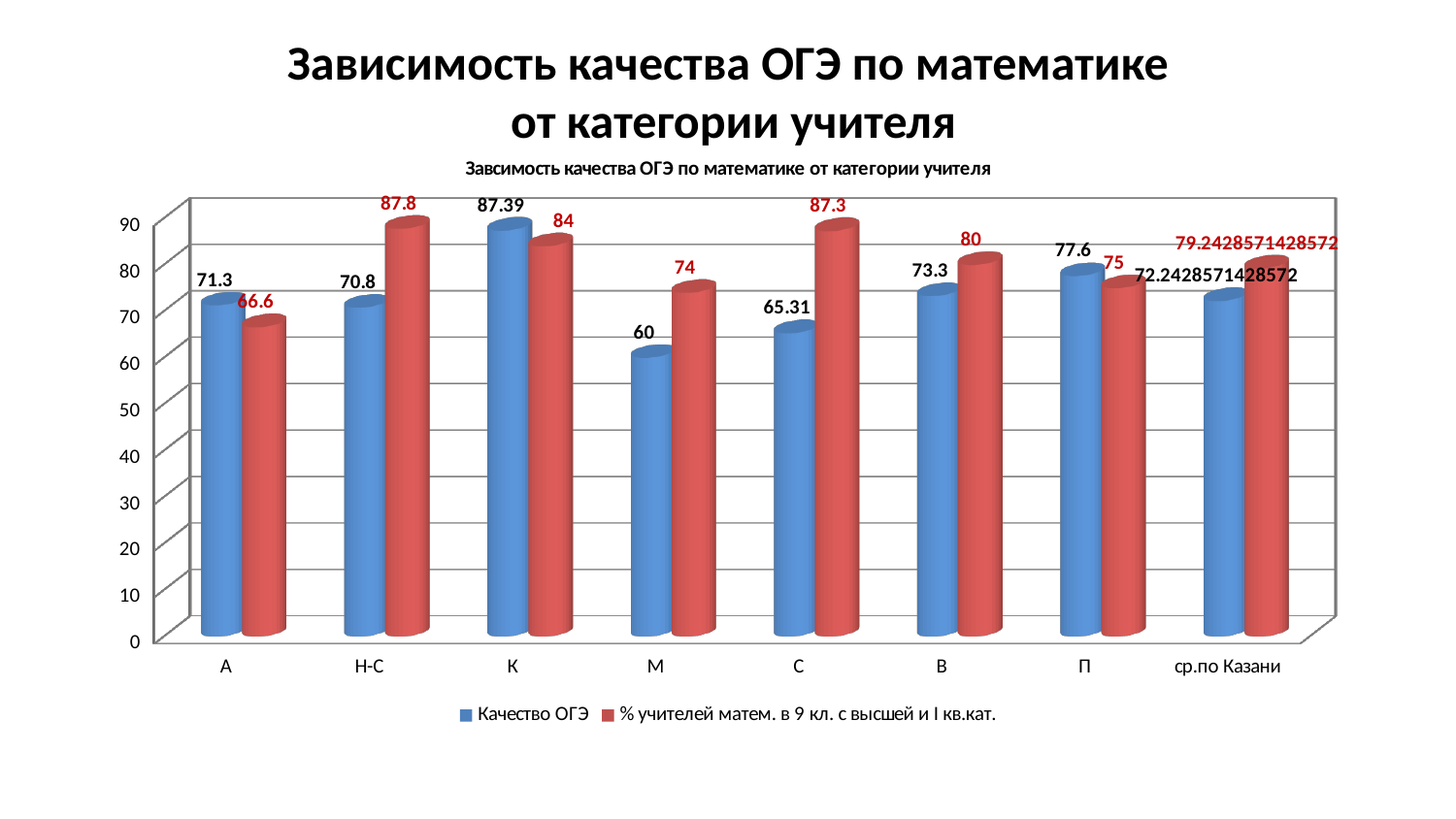
For category С, which is larger: Качество ОГЭ or % учителей матем. в 9 кл. с высшей и I кв.кат.? % учителей матем. в 9 кл. с высшей и I кв.кат. What kind of chart is shown on the slide? Bar chart What is the value of % учителей матем. в 9 кл. с высшей и I кв.кат. for category Н-С? 87.8 What is the difference between the % учителей матем. в 9 кл. с высшей и I кв.кат. value and the Качество ОГЭ value for category М? 14 What is the value of Качество ОГЭ for category К? 87.39 Which category has the lowest value of Качество ОГЭ? М What is the value of % учителей матем. в 9 кл. с высшей и I кв.кат. for category А? 66.6 Which category has the lowest value of % учителей матем. в 9 кл. с высшей и I кв.кат.? А What is the value of Качество ОГЭ for category М? 60 How many categories are shown on the x axis? 8 How many series does the legend list? 2 Which category has the highest value of Качество ОГЭ? К